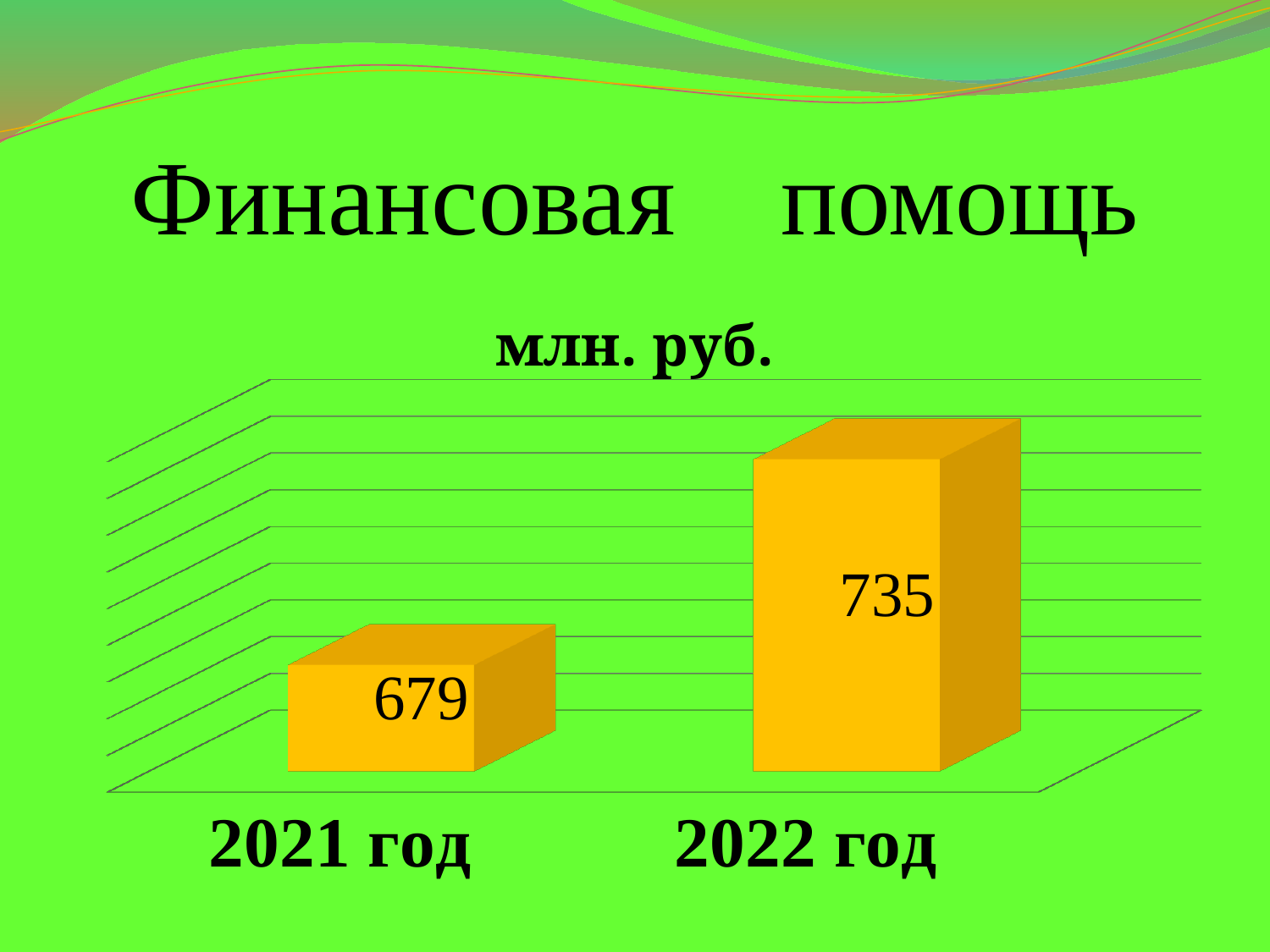
What kind of chart is shown on the slide? bar chart What is the title of the chart? млн. руб. How many categories are shown in the chart? 2 Which year has the highest value? 2022 год What is the value for 2022 год? 735 What is the value for 2021 год? 679 What colour are the bars in the chart? yellow Do the values rise or fall from 2021 год to 2022 год? rise What is the difference between the values for 2022 год and 2021 год? 56 Which is larger, the value for 2021 год or the value for 2022 год? 2022 год Which year has the lowest value? 2021 год